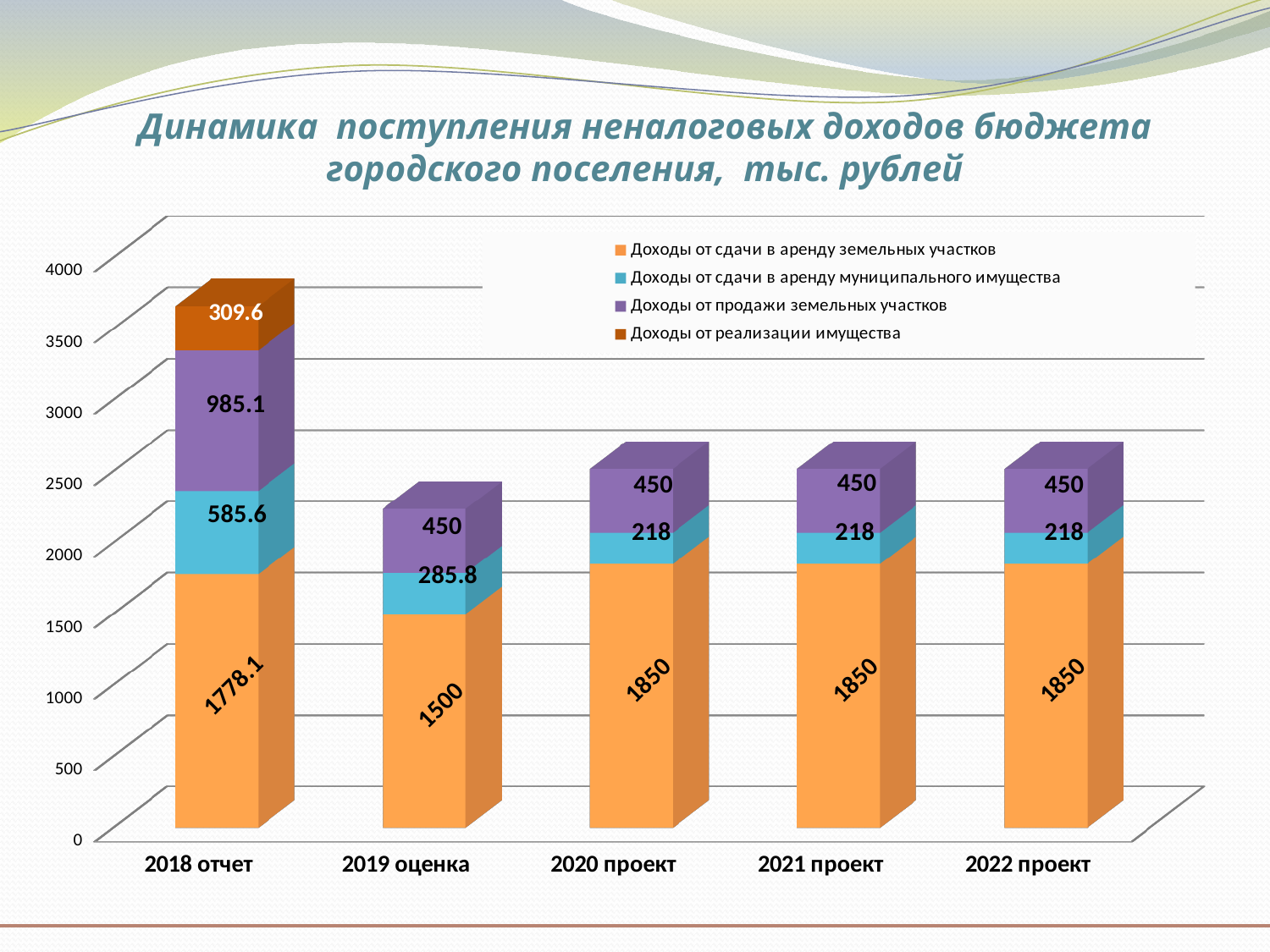
Which is larger: 'Доходы от сдачи в аренду земельных участков' for '2018 отчет' or for '2022 проект'? 2022 проект What kind of chart is shown on the slide? stacked bar chart Which category has the highest value for 'Доходы от продажи земельных участков'? 2018 отчет How many categories are shown on the x axis? 5 What is the value of 'Доходы от сдачи в аренду земельных участков' for '2018 отчет'? 1778.1 Which category has the lowest value for 'Доходы от сдачи в аренду земельных участков'? 2019 оценка What is the value of 'Доходы от сдачи в аренду муниципального имущества' for '2019 оценка'? 285.8 What is the difference between 'Доходы от сдачи в аренду муниципального имущества' for '2018 отчет' and '2020 проект'? 367.6 What is the value of 'Доходы от продажи земельных участков' for '2021 проект'? 450 What is the total of the stacked bar for '2019 оценка'? 2235.8 What is the value of 'Доходы от реализации имущества' for '2018 отчет'? 309.6 How many series does the legend list? 4